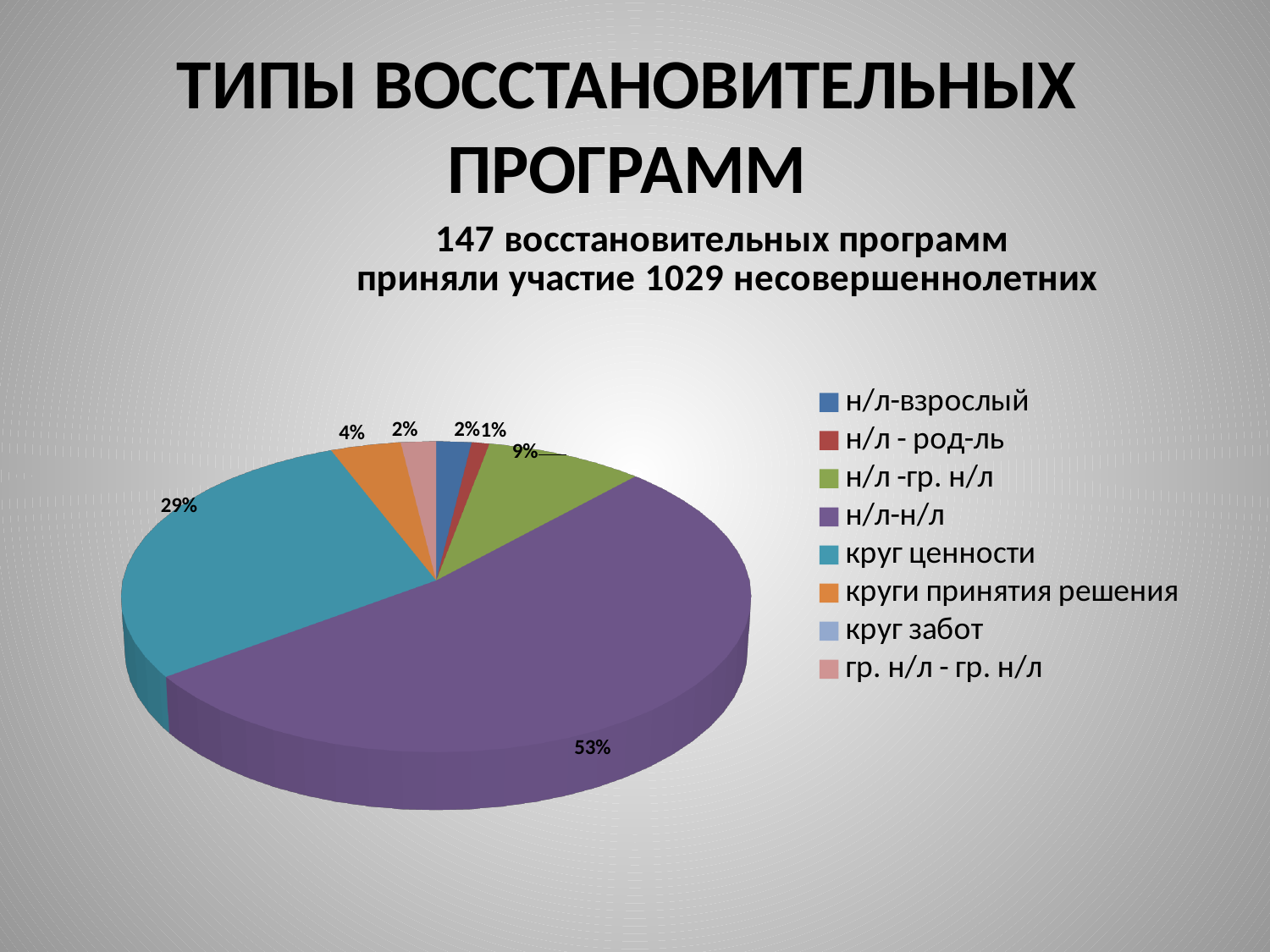
What colour is the "н/л-н/л" slice in the pie chart? purple What is the difference in percentage points between the "н/л-н/л" slice and the "круг ценности" slice? 24 Which is larger, the slice for "круг ценности" or the slice for "н/л -гр. н/л"? круг ценности How many entries does the legend list? 8 What type of chart is shown on the slide? pie chart What share of the pie does the "круг ценности" slice represent? 29% What share of the pie does the "круги принятия решения" slice represent? 4% Which category has the largest slice of the pie? н/л-н/л What share of the pie does the "н/л-н/л" slice represent? 53% What is the title of the slide containing the chart? ТИПЫ ВОССТАНОВИТЕЛЬНЫХ ПРОГРАММ